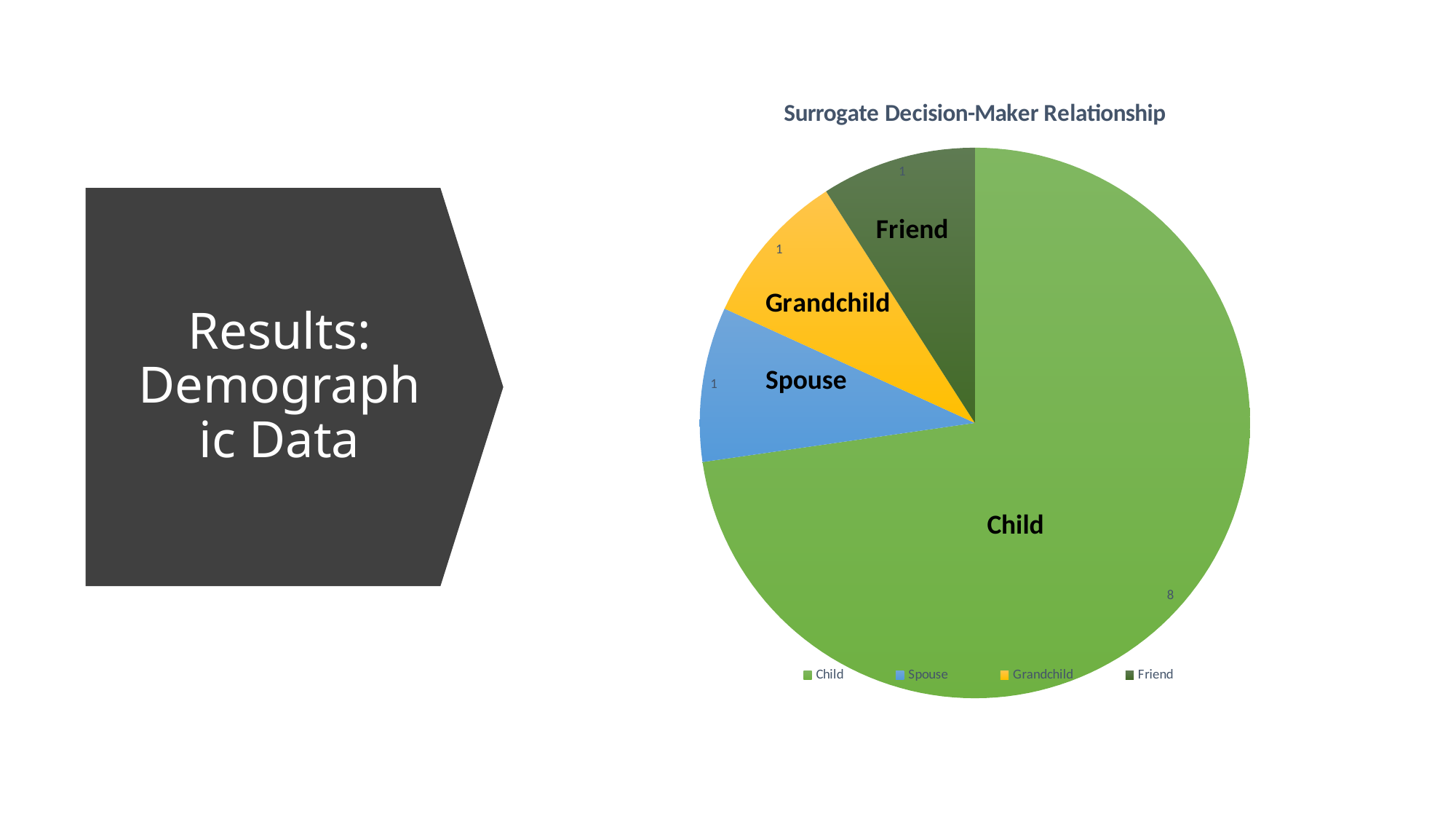
What is the total of all the values in the pie chart? 11 Which category has the largest slice? Child How many categories does the pie chart have? 4 What is the difference between the value for Child and the value for Spouse? 7 What is the value for Spouse? 1 What kind of chart is shown on the slide? Pie chart What colour is the Grandchild slice? Yellow What is the value for Friend? 1 What is the value for Grandchild? 1 What is the title of the chart? Surrogate Decision-Maker Relationship Which is larger, the value for Child or the value for Friend? Child What is the value for Child? 8